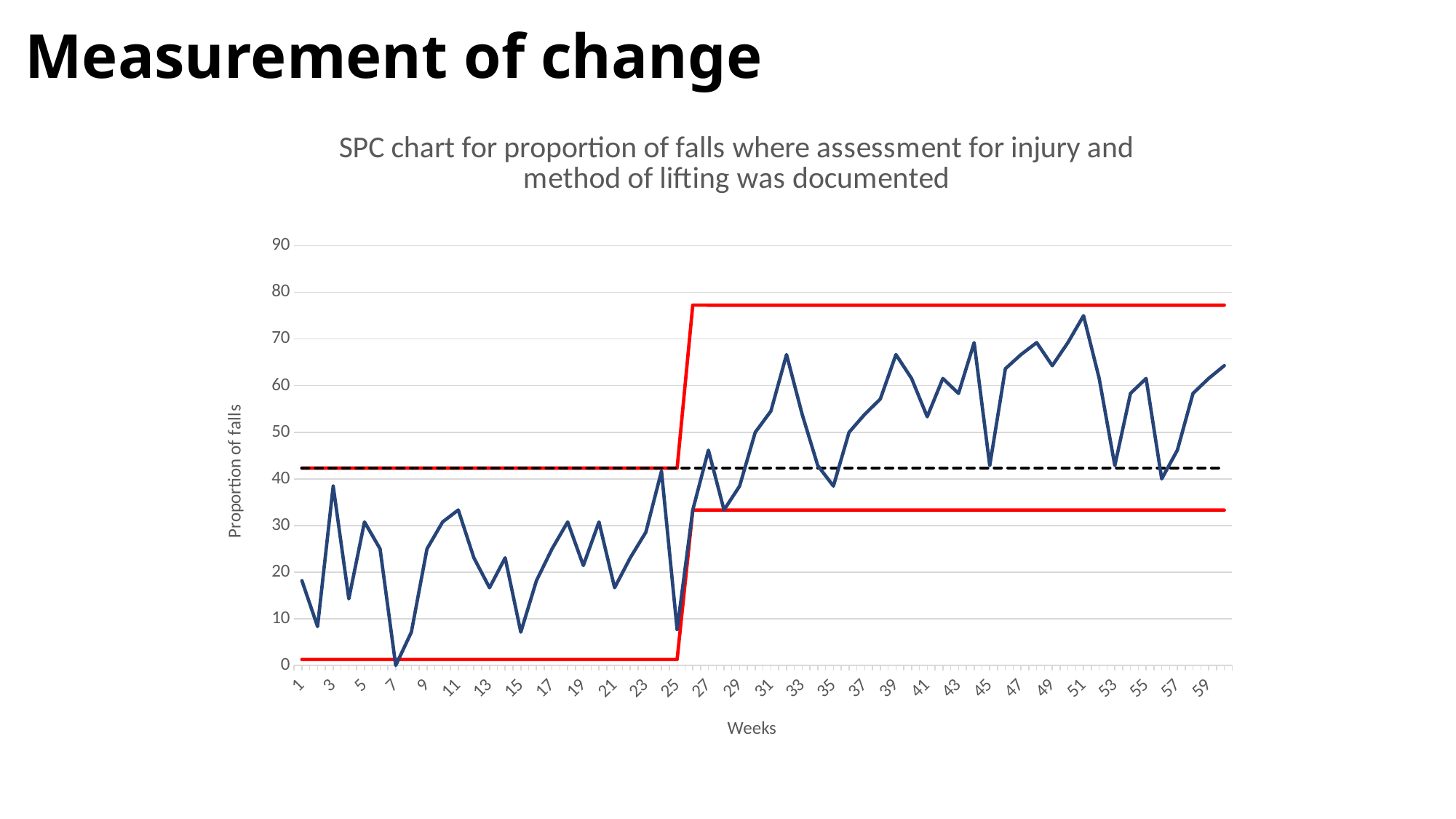
Is the value for week 7 greater or less than 10? less Is the value for week 51 greater or less than 70? greater What kind of chart is shown on the slide? Line chart At which week does the plotted proportion of falls reach its highest value? Week 51 Is the value for week 33 greater or less than 60? less Which week has the larger value, week 33 or week 3? Week 33 Do the plotted values generally rise or fall from the first half of the weeks to the second half? Rise What is the label on the vertical axis of the chart? Proportion of falls At which week does the plotted proportion of falls reach its lowest value? Week 7 What is the title of the chart? SPC chart for proportion of falls where assessment for injury and method of lifting was documented